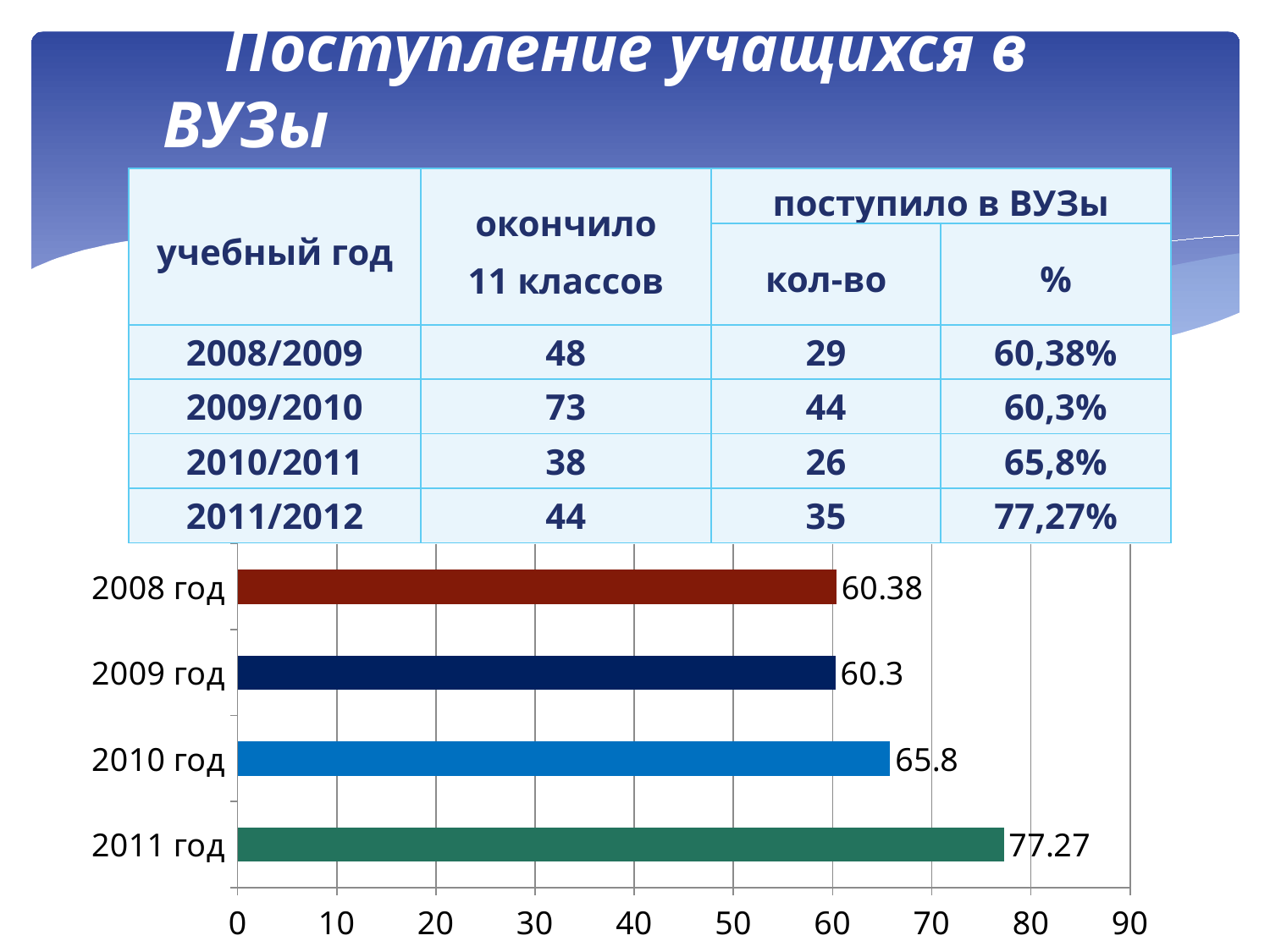
In the bar chart, which is larger: the value for 2010 год or the value for 2009 год? 2010 год How many bars are plotted in the bar chart? 4 What is the value shown for 2009 год in the bar chart? 60.3 What is the value shown for 2008 год in the bar chart? 60.38 What is the value shown for 2011 год in the bar chart? 77.27 What is the difference between the values for 2010 год and 2009 год in the bar chart? 5.5 What type of chart is shown at the bottom of the slide? bar chart Which year has the highest value in the bar chart? 2011 год Is the value for 2011 год in the bar chart greater or less than 70? greater What colour is the bar for 2011 год in the bar chart? green What is the value shown for 2010 год in the bar chart? 65.8 What is the difference between the values for 2011 год and 2008 год in the bar chart? 16.89